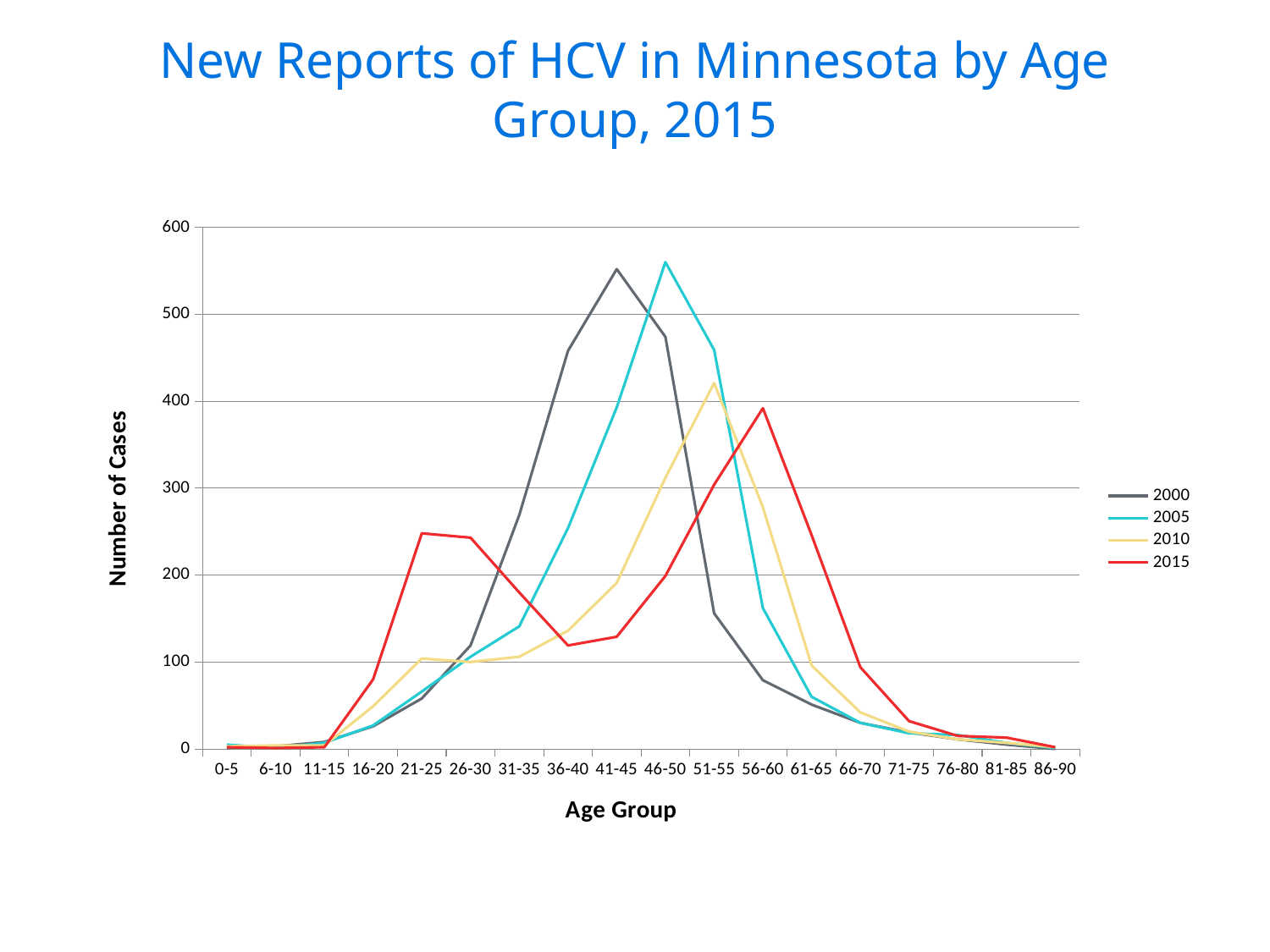
What is the label of the y axis? Number of Cases What kind of chart is shown on the slide? Line chart Is the value for the 2005 series at age group 56-60 greater or less than 200? less Is the value for the 2000 series at age group 41-45 greater or less than 500? greater Is the value for the 2015 series at age group 21-25 greater or less than 200? greater How many series does the legend list? 4 In which age group does the 2005 series reach its highest value? 46-50 In which age group does the 2000 series reach its highest value? 41-45 Does the 2015 series rise or fall from age group 56-60 to 86-90? Fall How many age groups are shown on the x axis? 18 At age group 21-25, which series has the higher value, 2015 or 2000? 2015 In which age group does the 2015 series reach its highest value? 56-60